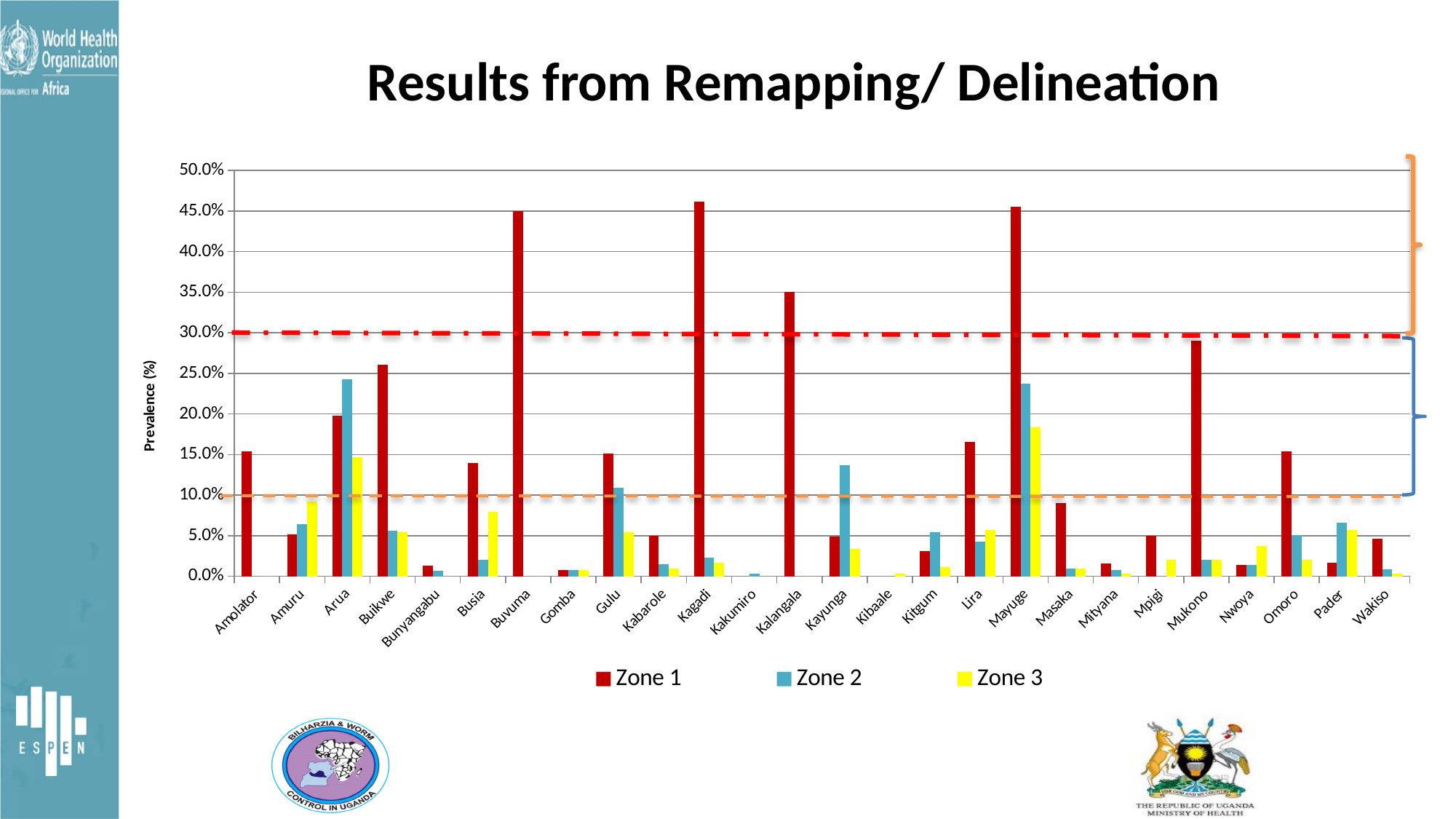
For Arua, which is larger: the Zone 1 value or the Zone 2 value? Zone 2 What is the label of the y axis? Prevalence (%) Which district has the highest Zone 3 value? Mayuge Is the Zone 2 value for Arua greater or less than 20.0%? greater What kind of chart is shown on the slide? bar chart For Kayunga, which is larger: the Zone 1 value or the Zone 2 value? Zone 2 Is the Zone 1 value for Bunyangabu greater or less than 5.0%? less How many districts (categories) are shown on the x axis? 26 Is the Zone 1 value for Buvuma greater or less than 40.0%? greater How many series does the legend list? 3